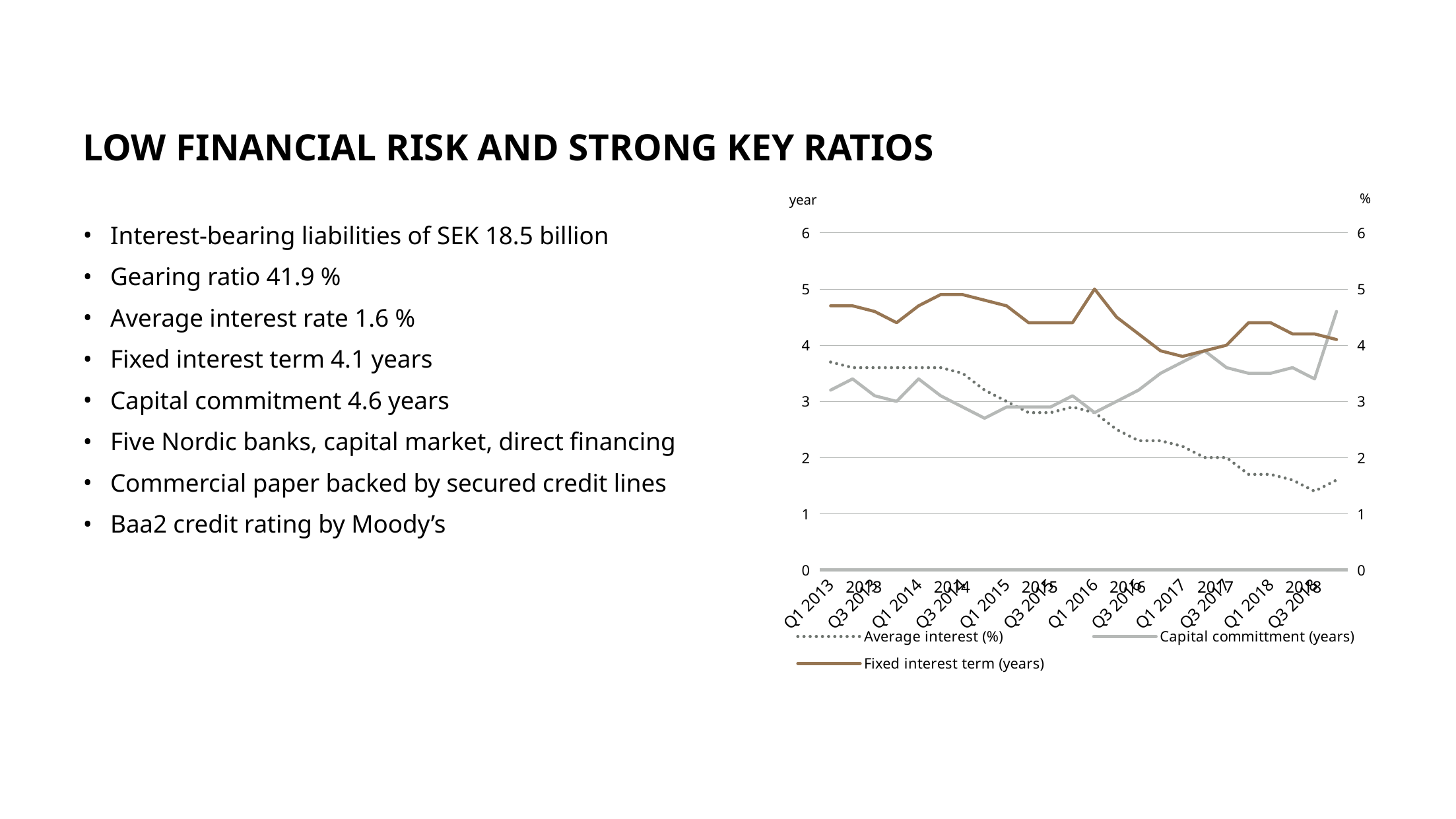
Is the value for Fixed interest term (years) at Q1 2013 greater or less than 4? greater Is the value for Average interest (%) at Q3 2018 greater or less than 2? less What kind of chart is shown on the slide? line chart Does the Capital committment (years) series rise or fall overall from Q1 2013 to the end of the chart? rise At Q1 2013, which is higher: Fixed interest term (years) or Average interest (%)? Fixed interest term (years) Does the Average interest (%) series rise or fall overall from Q1 2013 to the end of the chart? fall What is the label on the left vertical axis of the chart? year How many series does the chart's legend list? 3 Which series is drawn with a dotted line in the chart? Average interest (%) Which series has the lowest value at the last point on the chart? Average interest (%) Is the value for Average interest (%) at Q1 2013 greater or less than 3? greater